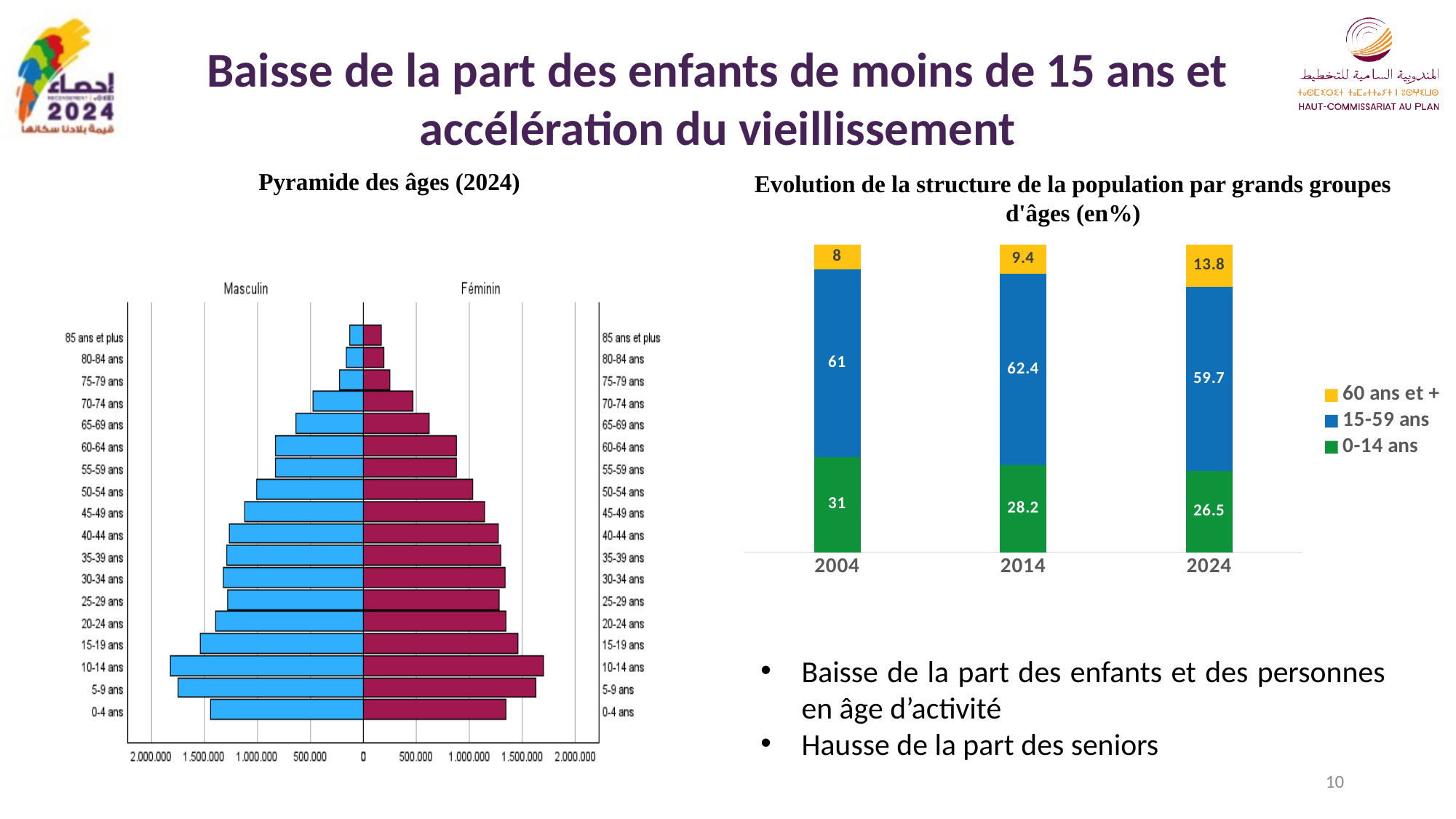
In the chart 'Evolution de la structure de la population par grands groupes d'âges (en%)', what is the total of the stacked bar for 2014? 100 In the chart 'Evolution de la structure de la population par grands groupes d'âges (en%)', what is the difference between the 0-14 ans value in 2004 and in 2024? 4.5 In the chart 'Evolution de la structure de la population par grands groupes d'âges (en%)', how does the 60 ans et + value change from 2004 to 2024? It rises In the chart 'Evolution de la structure de la population par grands groupes d'âges (en%)', what is the value for 15-59 ans in 2004? 61 In the chart 'Evolution de la structure de la population par grands groupes d'âges (en%)', how many series does the legend list? 3 In the chart 'Evolution de la structure de la population par grands groupes d'âges (en%)', what is the value for 60 ans et + in 2014? 9.4 In the chart 'Evolution de la structure de la population par grands groupes d'âges (en%)', what is the value for 0-14 ans in 2024? 26.5 In the chart 'Evolution de la structure de la population par grands groupes d'âges (en%)', which year has the lowest value for 0-14 ans? 2024 In the chart 'Evolution de la structure de la population par grands groupes d'âges (en%)', is the 15-59 ans value larger in 2014 or in 2024? 2014 In the chart 'Evolution de la structure de la population par grands groupes d'âges (en%)', which year has the highest value for 60 ans et +? 2024 In the chart 'Pyramide des âges (2024)', is the Masculin value for 10-14 ans greater or less than 1.500.000? greater In the chart 'Pyramide des âges (2024)', how many age groups are shown? 18